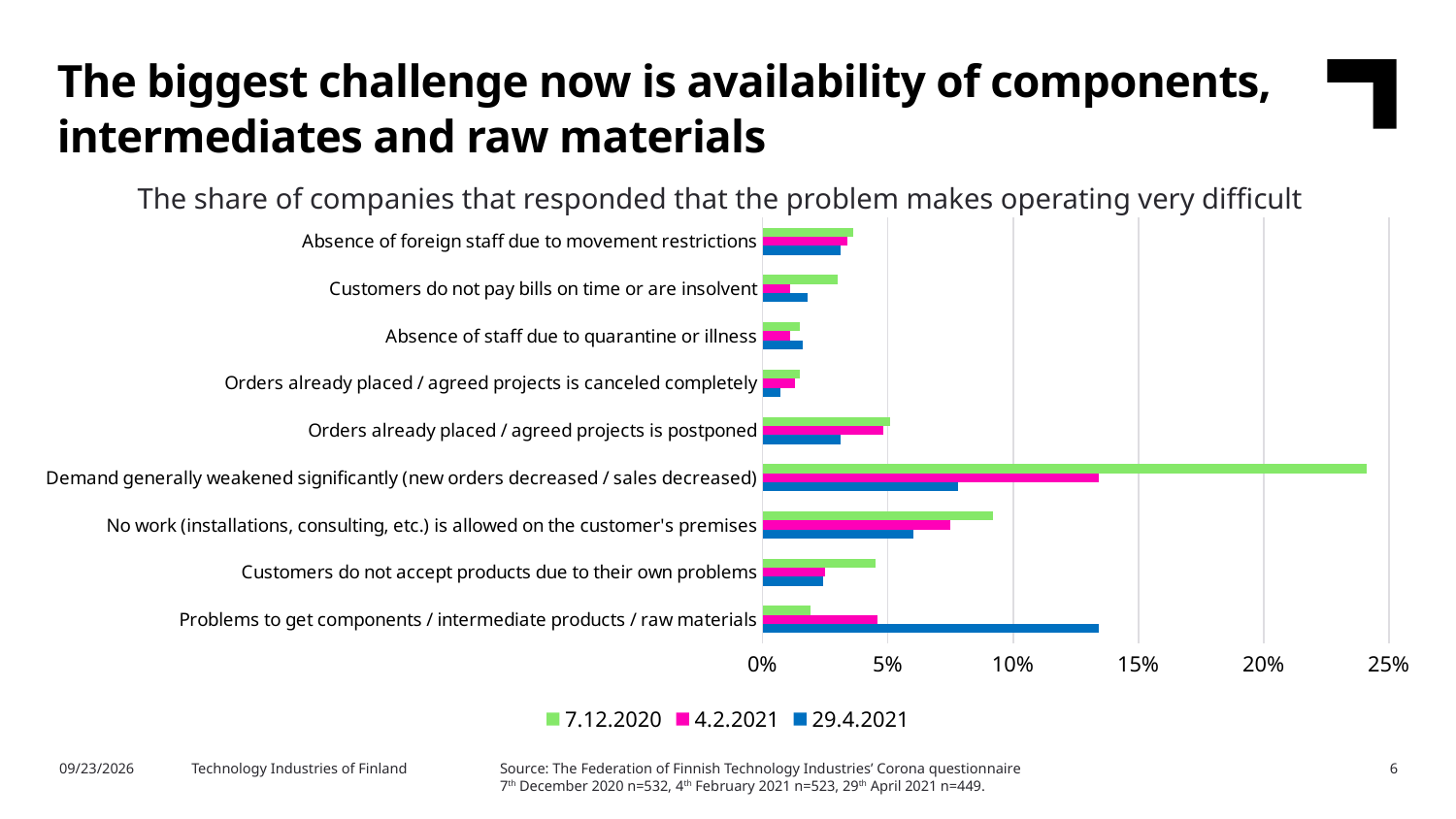
Which category has the highest value for the 29.4.2021 series? Problems to get components / intermediate products / raw materials Is the 29.4.2021 value for 'Problems to get components / intermediate products / raw materials' greater or less than 10%? greater Is the 7.12.2020 value for 'No work (installations, consulting, etc.) is allowed on the customer's premises' greater or less than 10%? less Which category has the highest value for the 7.12.2020 series? Demand generally weakened significantly (new orders decreased / sales decreased) What kind of chart is shown on the slide? Bar chart What are the three series listed in the legend? 7.12.2020, 4.2.2021, 29.4.2021 How many series does the legend list? 3 Is the 7.12.2020 value for 'Demand generally weakened significantly' greater or less than 20%? greater For 'Problems to get components / intermediate products / raw materials', which series has the larger value: 7.12.2020 or 29.4.2021? 29.4.2021 How many problem categories are plotted on the chart? 9 For 'Demand generally weakened significantly', which series has the larger value: 7.12.2020 or 4.2.2021? 7.12.2020